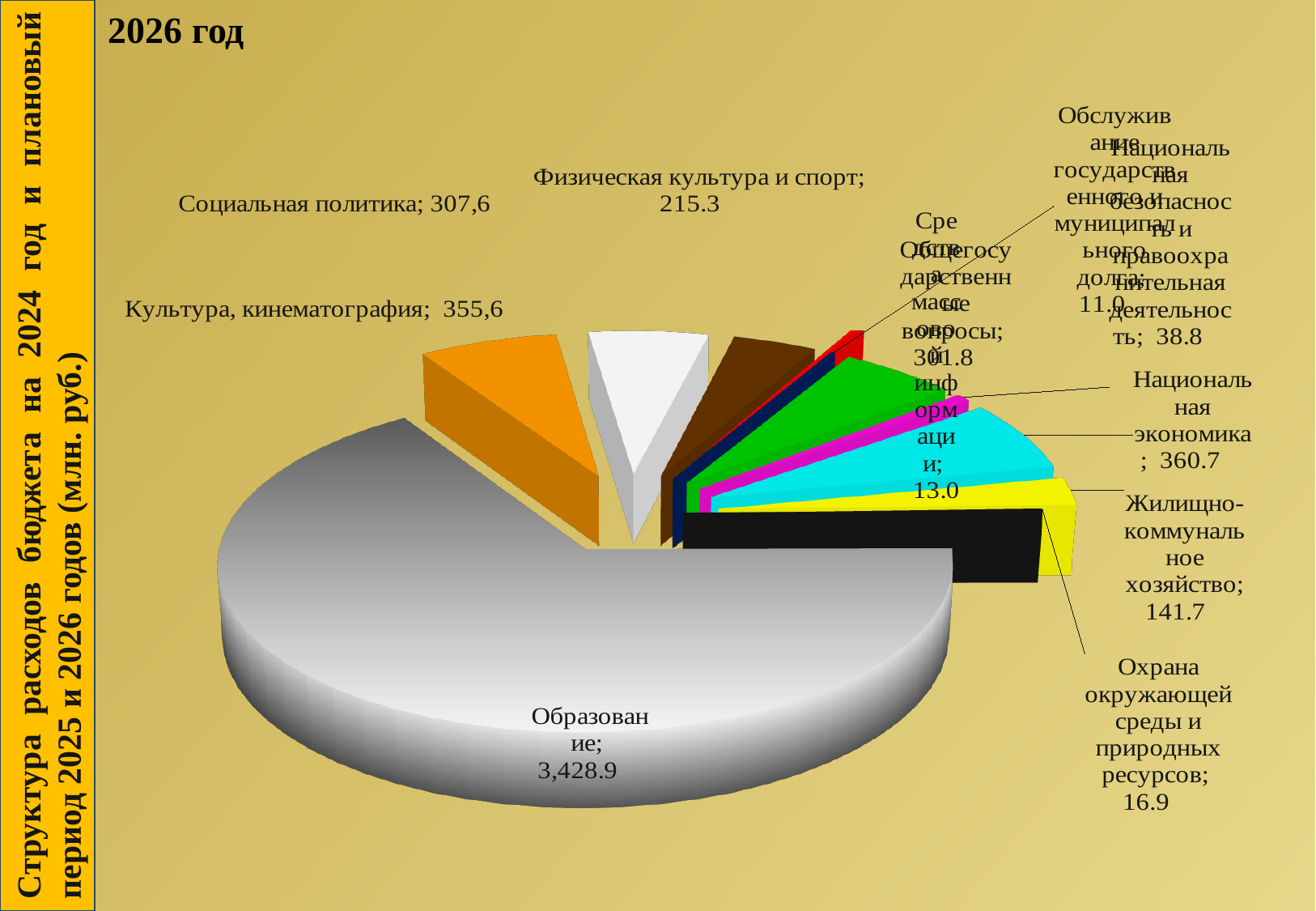
Which is larger, Национальная экономика or Жилищно-коммунальное хозяйство? Национальная экономика What is the value for Социальная политика? 307,6 What kind of chart is shown on the slide? pie chart What is the value for Национальная экономика? 360.7 What is the value for Жилищно-коммунальное хозяйство? 141.7 What is the value for Физическая культура и спорт? 215.3 What is the value for Культура, кинематография? 355,6 What is the difference between Жилищно-коммунальное хозяйство and Охрана окружающей среды и природных ресурсов? 124.8 What is the value for Образование? 3,428.9 What is the value for Охрана окружающей среды и природных ресурсов? 16.9 Which category has the largest slice of the pie? Образование What year is shown in the chart title? 2026 год